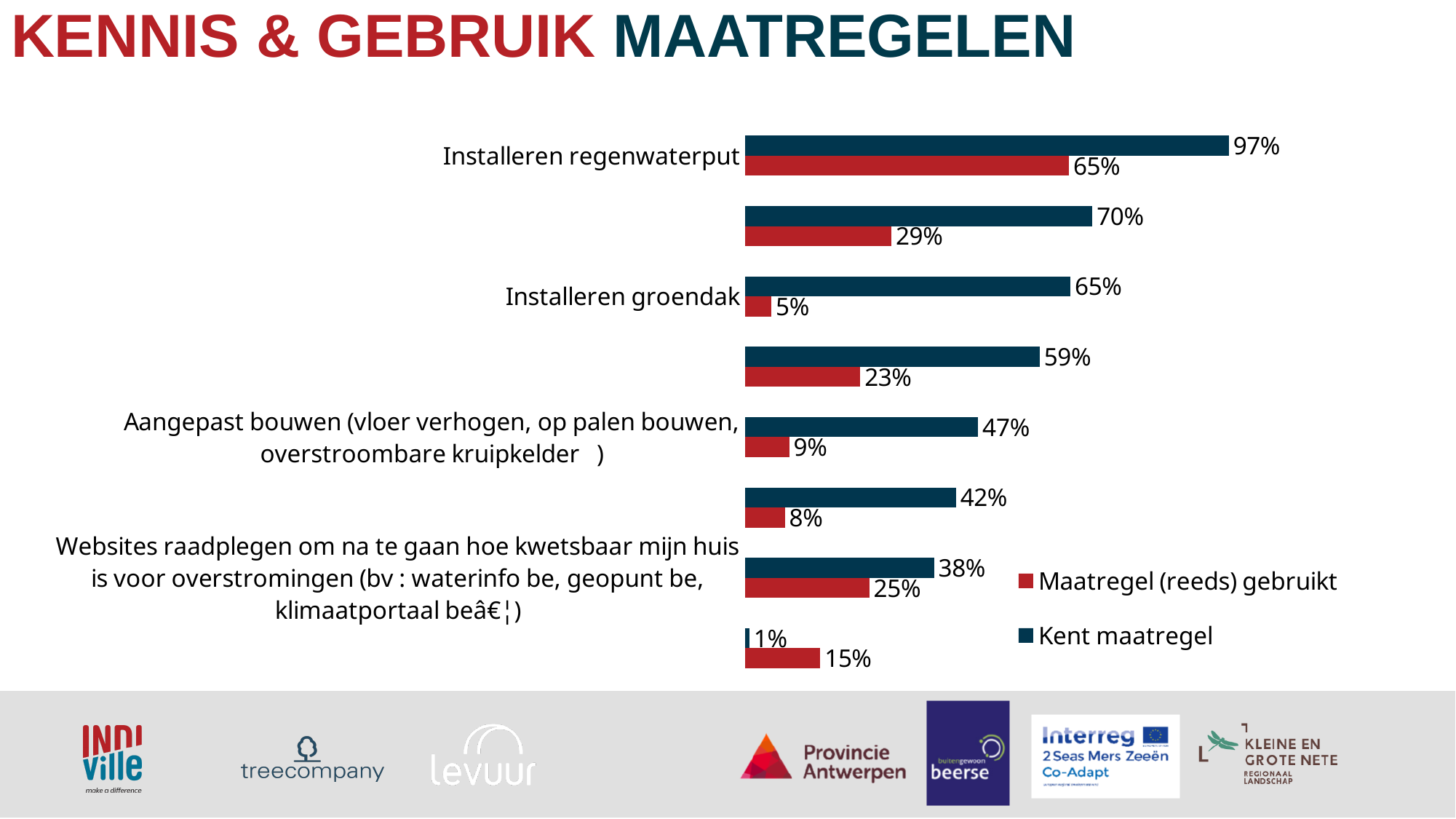
For 'Installeren groendak', which is larger: 'Kent maatregel' or 'Maatregel (reeds) gebruikt'? Kent maatregel What is the value of 'Kent maatregel' for 'Aangepast bouwen (vloer verhogen, op palen bouwen, overstroombare kruipkelder)'? 47% What kind of chart is shown on the slide? Bar chart What is the difference between 'Kent maatregel' and 'Maatregel (reeds) gebruikt' for 'Installeren groendak'? 60 percentage points What is the value of 'Maatregel (reeds) gebruikt' for 'Installeren regenwaterput'? 65% What is the value of 'Maatregel (reeds) gebruikt' for 'Installeren groendak'? 5% What is the difference between 'Kent maatregel' and 'Maatregel (reeds) gebruikt' for 'Installeren regenwaterput'? 32 percentage points What is the value of 'Kent maatregel' for 'Installeren regenwaterput'? 97% How many series does the legend list? 2 What is the value of 'Kent maatregel' for 'Installeren groendak'? 65% Which category has the highest 'Kent maatregel' value? Installeren regenwaterput What is the value of 'Maatregel (reeds) gebruikt' for 'Websites raadplegen om na te gaan hoe kwetsbaar mijn huis is voor overstromingen'? 25%